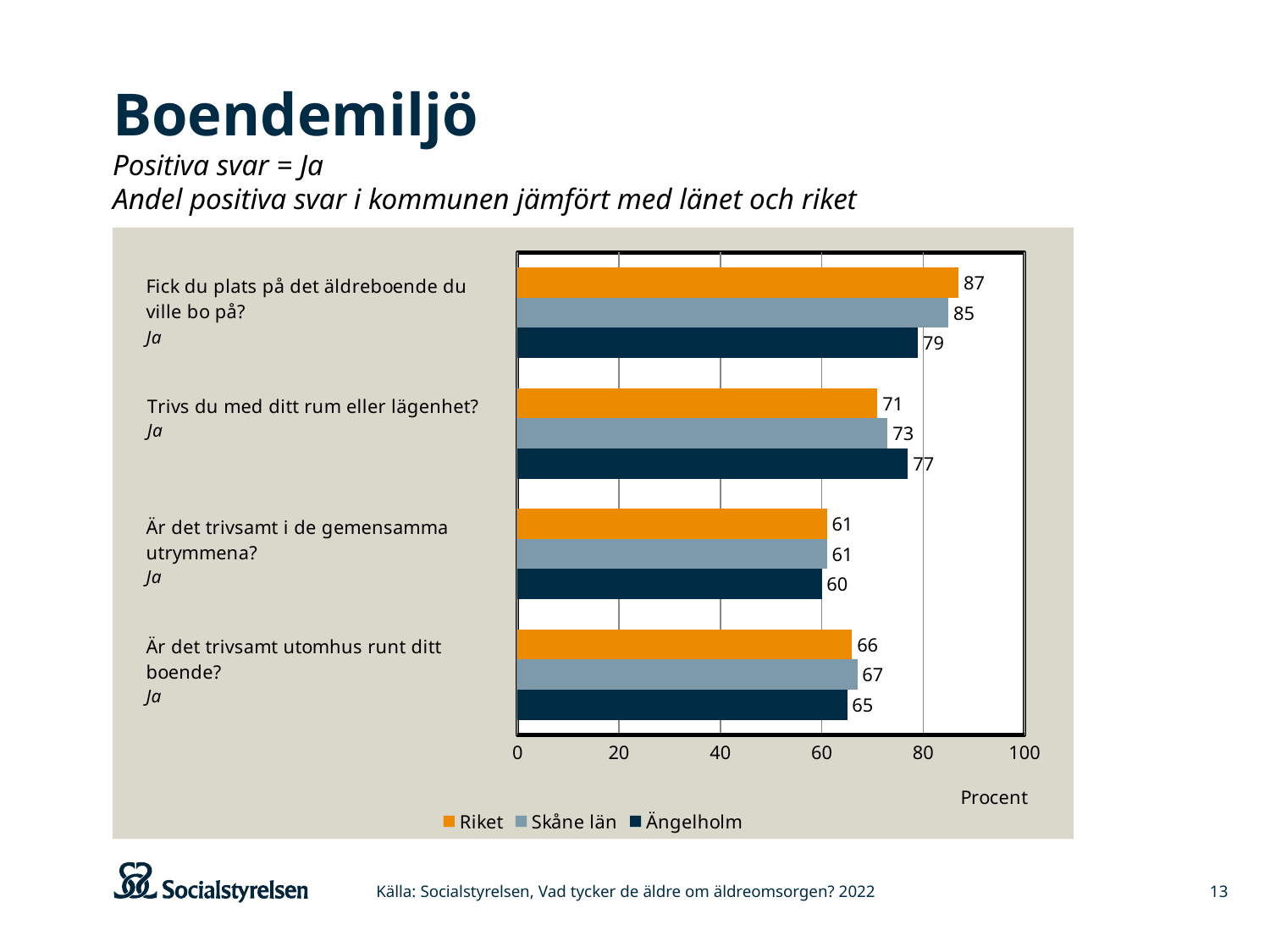
Which question has the lowest value for Ängelholm? Är det trivsamt i de gemensamma utrymmena? What is the value for Riket on "Trivs du med ditt rum eller lägenhet?"? 71 What is the value for Ängelholm on "Fick du plats på det äldreboende du ville bo på?"? 79 What is the difference between Riket and Ängelholm on "Fick du plats på det äldreboende du ville bo på?"? 8 What is the value for Skåne län on "Är det trivsamt utomhus runt ditt boende?"? 67 Is the value for Skåne län on "Fick du plats på det äldreboende du ville bo på?" greater or less than 80? greater How many series does the legend list? 3 What unit is shown on the x axis of the chart? Procent Which question has the highest value for Riket? Fick du plats på det äldreboende du ville bo på? What kind of chart is shown on the slide? Bar chart How many questions (categories) are shown in the chart? 4 Which is larger on "Trivs du med ditt rum eller lägenhet?": Riket or Ängelholm? Ängelholm